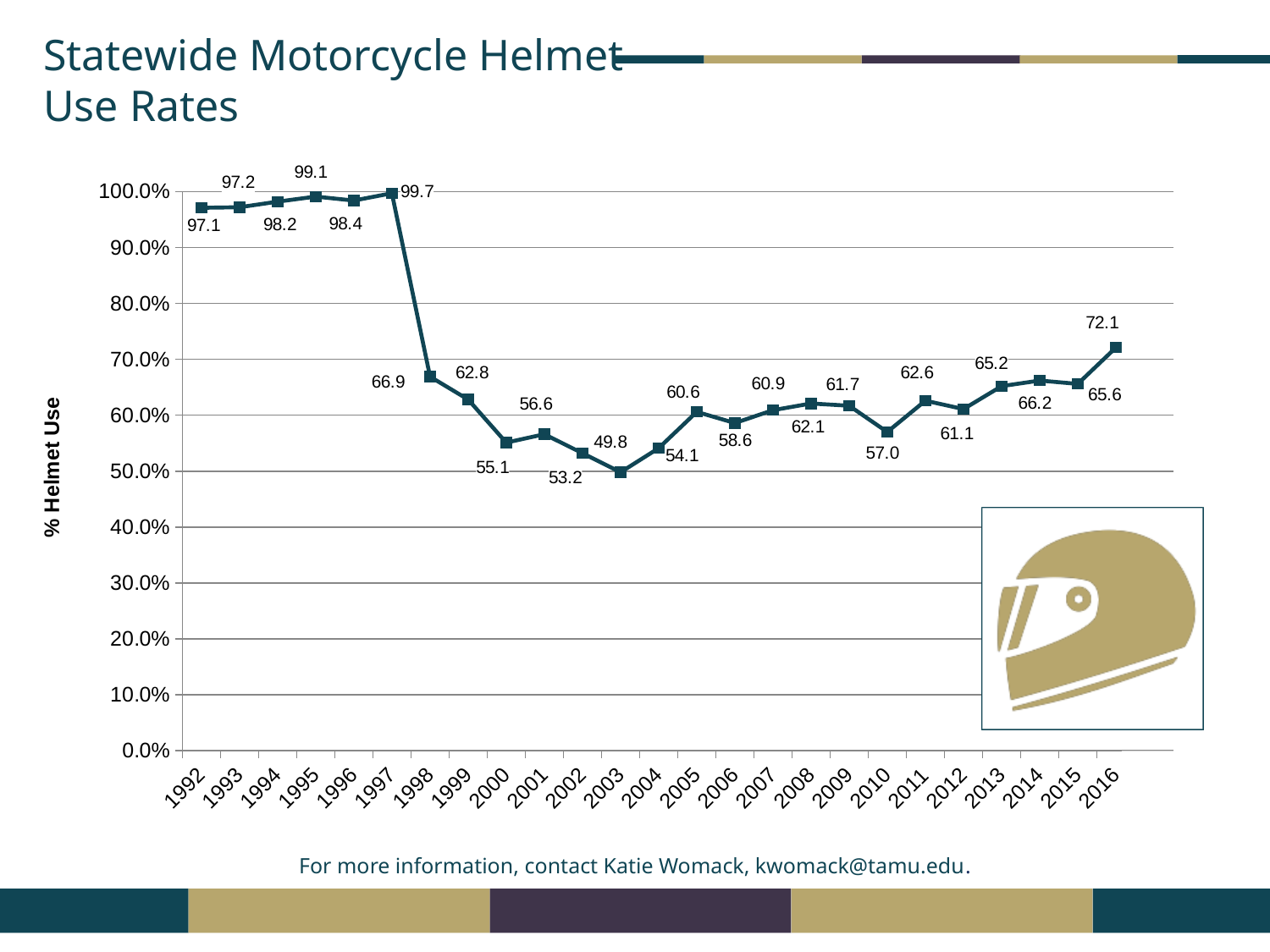
Is the helmet use rate for 2016 greater or less than 70.0%? greater What is the difference between the helmet use rates for 1997 and 1998? 32.8 What is the helmet use rate for 1997? 99.7 Which year has the highest helmet use rate? 1997 What is the helmet use rate for 2016? 72.1 Do the helmet use rates rise or fall from 2013 to 2016 overall? rise Which year has the lowest helmet use rate? 2003 What kind of chart is shown on the slide? line chart Which year has a higher helmet use rate, 2010 or 2011? 2011 How many years are plotted on the chart? 25 What is the label on the vertical axis of the chart? % Helmet Use What is the helmet use rate for 2003? 49.8